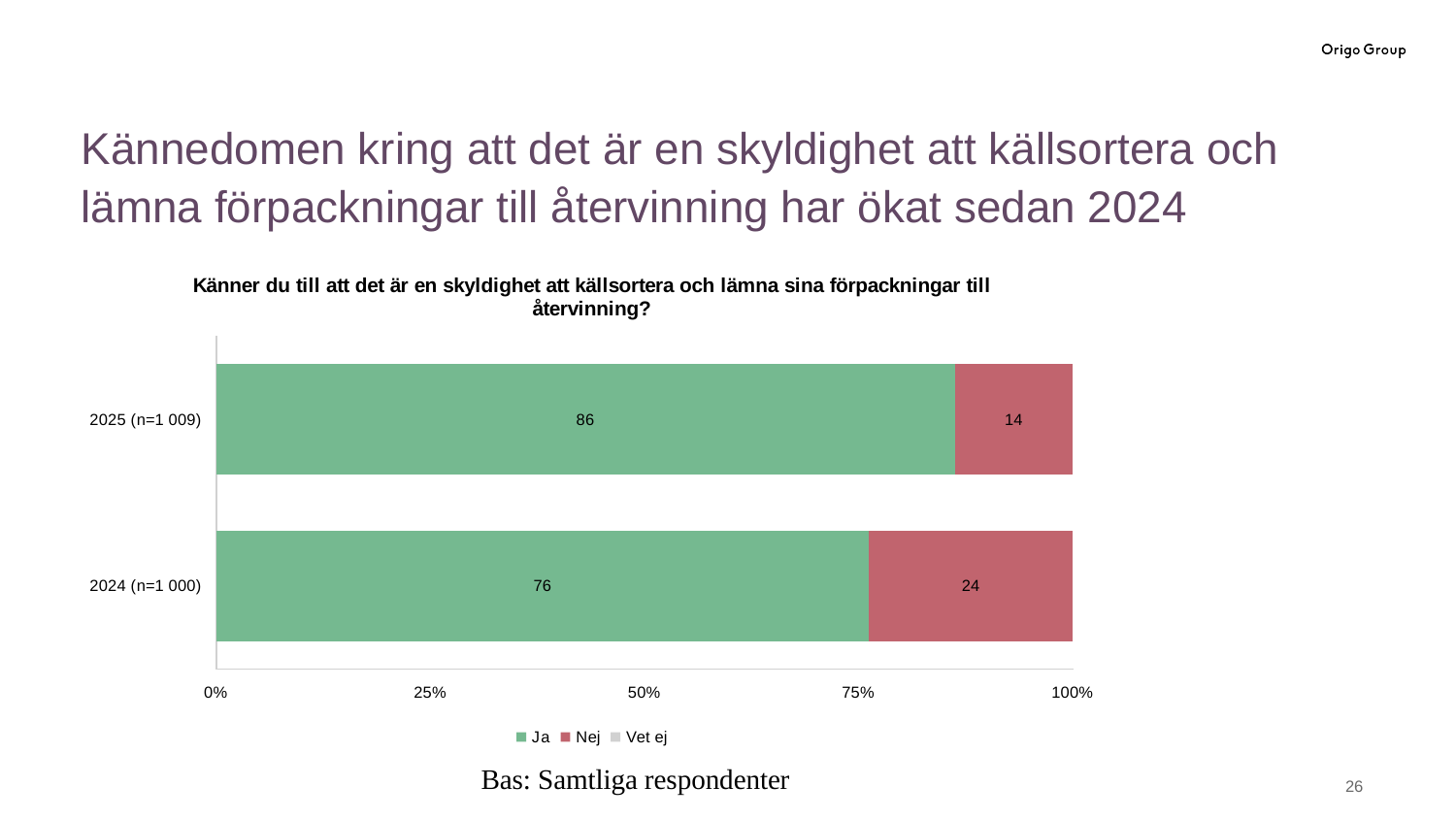
What is the value for "Ja" in 2025 (n=1 009)? 86 Is the "Nej" value larger in 2024 or in 2025? 2024 Which year has the higher value for "Ja"? 2025 (n=1 009) What is the value for "Nej" in 2024 (n=1 000)? 24 What is the total of the stacked bar for 2025 (n=1 009)? 100 Is the value for "Ja" in 2024 greater or less than 75%? greater What is the difference between the "Ja" values for 2025 and 2024? 10 What is the value for "Nej" in 2025 (n=1 009)? 14 What kind of chart is shown on the slide? Stacked bar chart What is the value for "Ja" in 2024 (n=1 000)? 76 How many series does the legend list? 3 Which year has the lower value for "Nej"? 2025 (n=1 009)